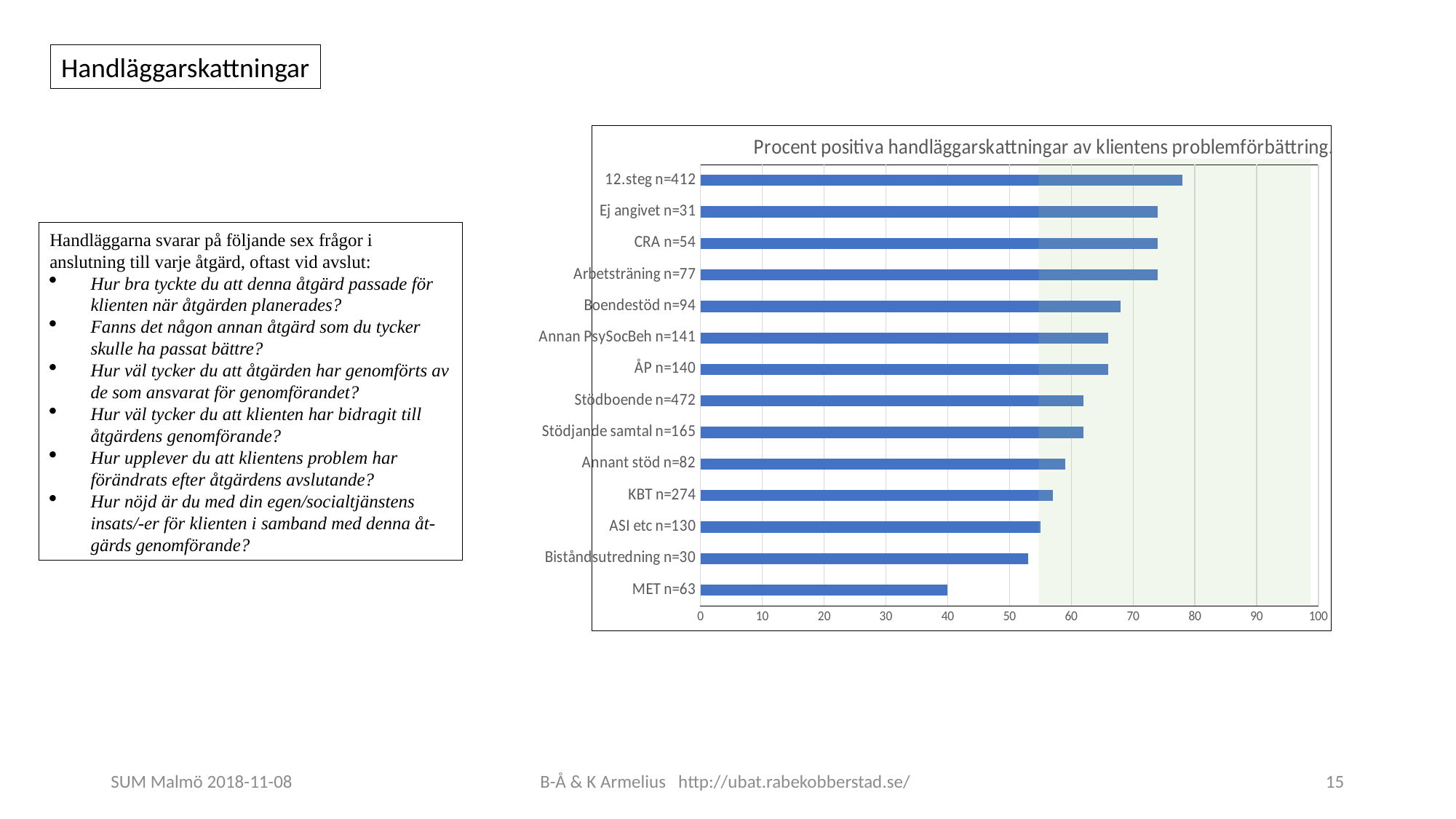
How many categories (bars) does the chart show? 14 Is the value for KBT n=274 greater or less than 60? less Is the value for 12.steg n=412 greater or less than 70? greater Which category has the lowest percentage of positive ratings? MET n=63 What is the maximum value shown on the horizontal axis of the chart? 100 Which category has the highest percentage of positive ratings? 12.steg n=412 Is the value for Boendestöd n=94 greater or less than 60? greater Which is larger, the value for ASI etc n=130 or the value for CRA n=54? CRA n=54 What kind of chart is shown on the slide? bar chart Which is larger, the value for Stödboende n=472 or the value for Biståndsutredning n=30? Stödboende n=472 What is the title of the chart? Procent positiva handläggarskattningar av klientens problemförbättring